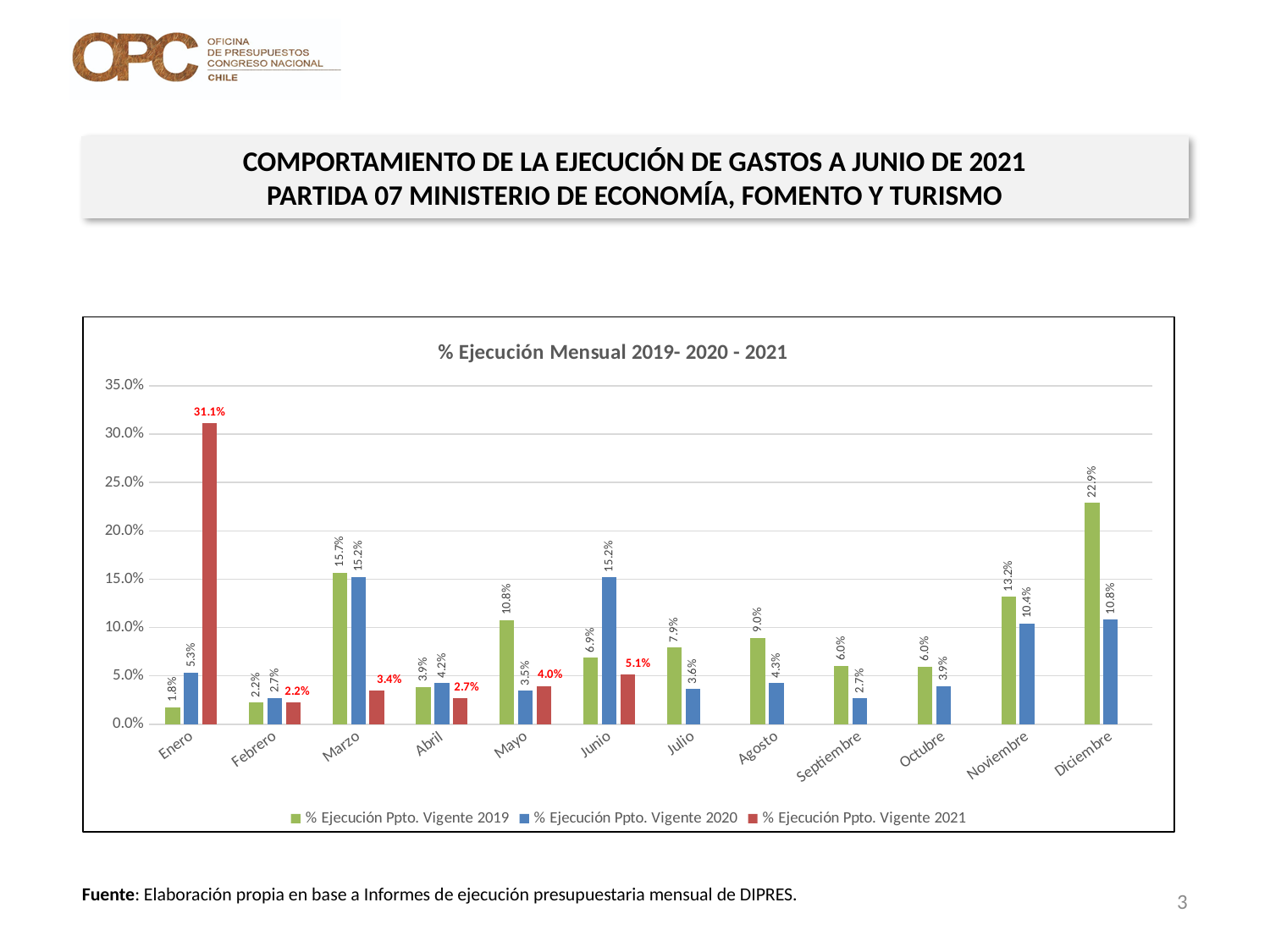
In which month is the % Ejecución Ppto. Vigente 2019 series lowest? Enero What is the value for % Ejecución Ppto. Vigente 2019 in Diciembre? 22.9% What is the difference between the 2019 and 2020 values in Marzo? 0.5% How many series does the legend list? 3 What is the value for % Ejecución Ppto. Vigente 2020 in Junio? 15.2% What is the title of the chart? % Ejecución Mensual 2019- 2020 - 2021 Is the value for % Ejecución Ppto. Vigente 2021 in Enero greater or less than 30.0%? greater How many months are shown on the x axis? 12 In which month is the % Ejecución Ppto. Vigente 2019 series highest? Diciembre Which is larger in Mayo: the 2019 value or the 2020 value? 2019 value (10.8%) What kind of chart is shown? Bar chart What is the value for % Ejecución Ppto. Vigente 2021 in Enero? 31.1%